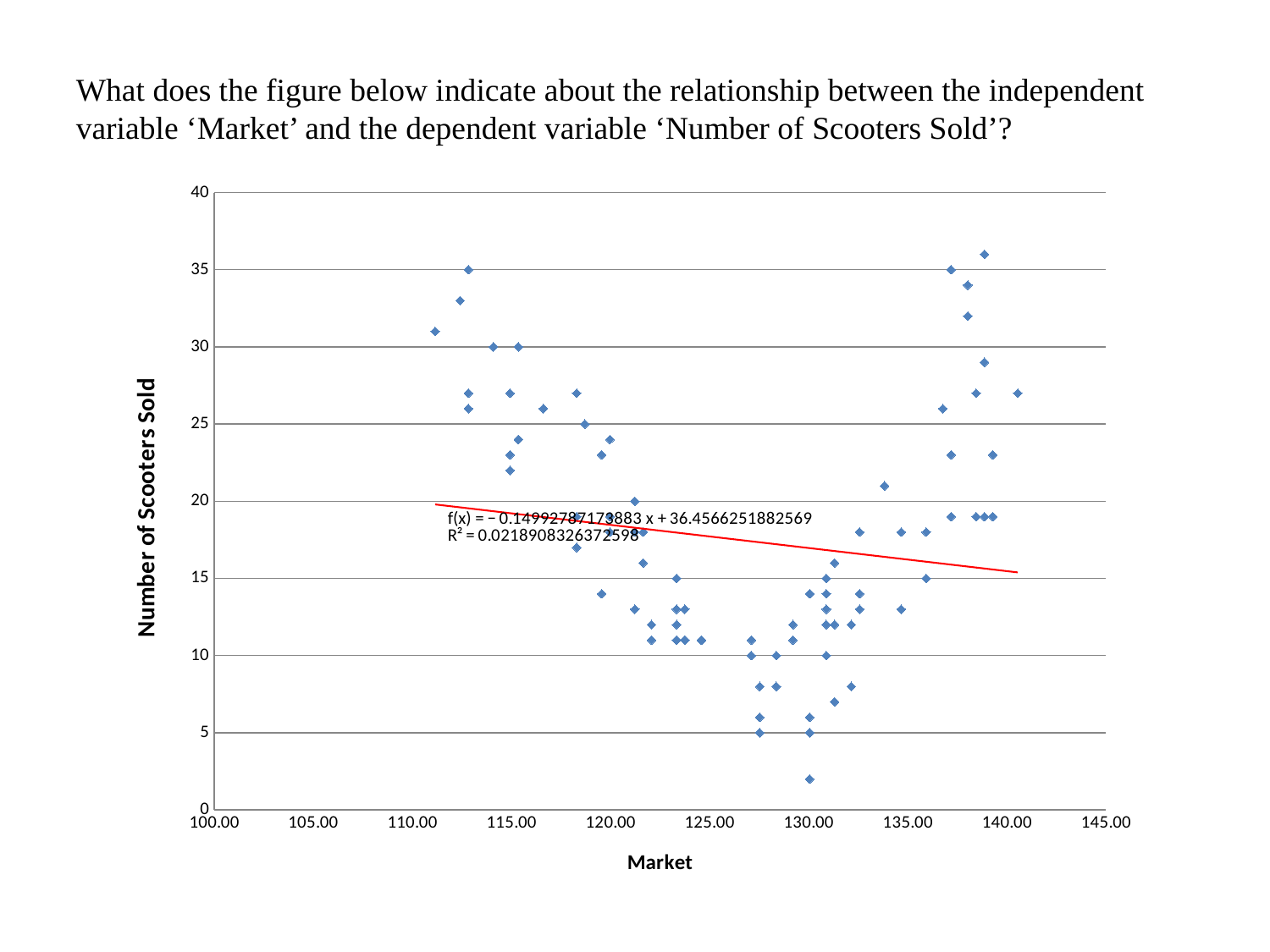
Is the lowest plotted Number of Scooters Sold value greater or less than 5? less Is the slope of the trend line equation shown on the chart positive or negative? Negative What is the highest value shown on the x axis of the chart? 145.00 What is the lowest value shown on the x axis of the chart? 100.00 What kind of chart is shown on the slide? Scatter chart What is the title of the x axis of the chart? Market Does the fitted trend line rise or fall as Market increases along the x axis? Falls Is the R² value printed on the chart greater or less than 0.5? less What is the title of the y axis of the chart? Number of Scooters Sold What is the highest value shown on the y axis of the chart? 40 Is the highest plotted Number of Scooters Sold value greater or less than 35? greater What is the intercept value in the trend line equation f(x) shown on the chart? 36.4566251882569